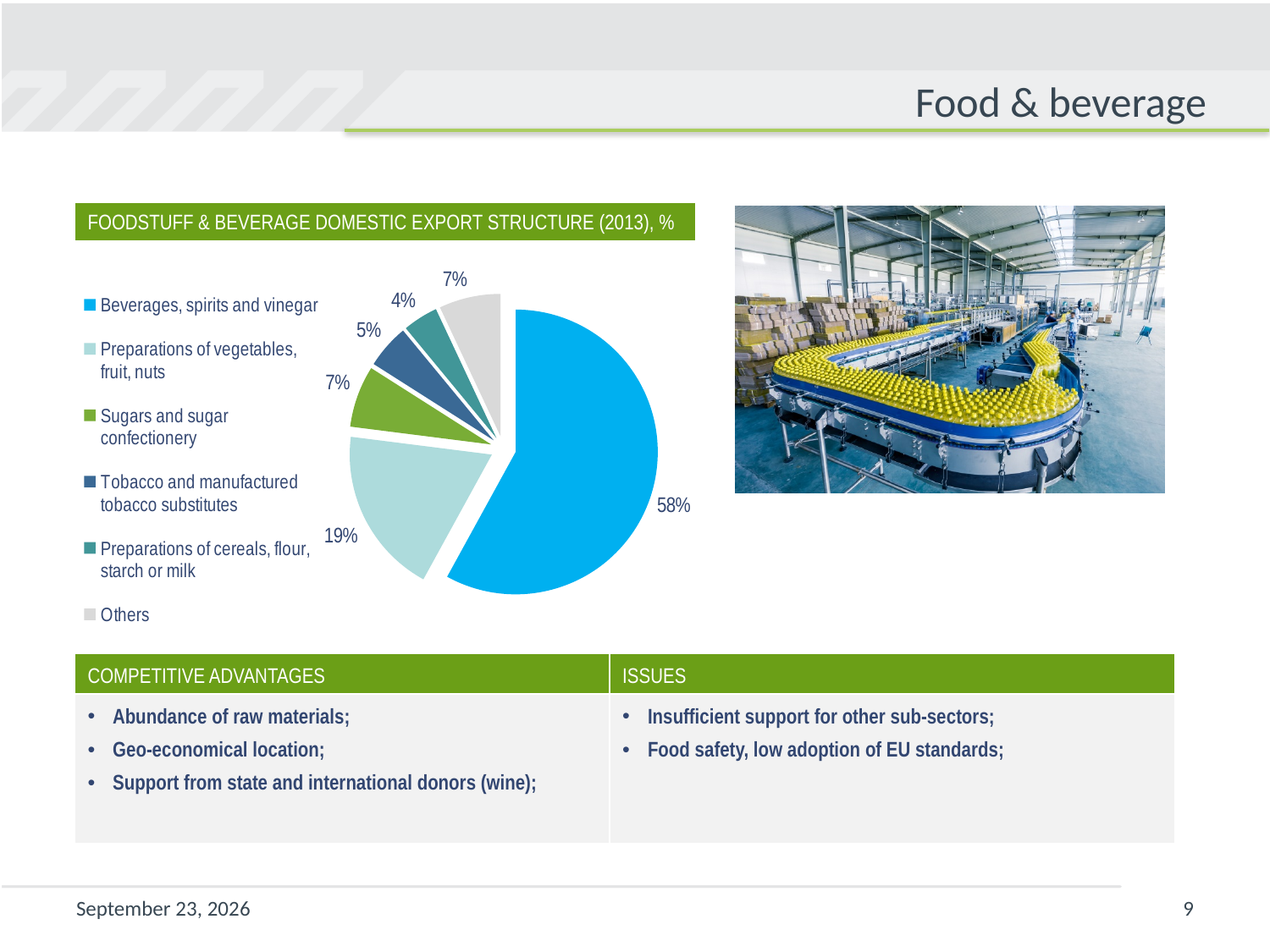
Which is larger: Sugars and sugar confectionery or Tobacco and manufactured tobacco substitutes? Sugars and sugar confectionery What type of chart is shown on the slide? Pie chart What is the difference in percentage points between Beverages, spirits and vinegar and Preparations of vegetables, fruit, nuts? 39 Which category has the largest share of the pie? Beverages, spirits and vinegar What share does the Others slice represent? 7% What percentage is shown for Preparations of vegetables, fruit, nuts? 19% What is the value for Tobacco and manufactured tobacco substitutes? 5% What percentage is shown for Preparations of cereals, flour, starch or milk? 4% What is the title of the chart? FOODSTUFF & BEVERAGE DOMESTIC EXPORT STRUCTURE (2013), % How many categories does the pie chart show? 6 Which category has the smallest share of the pie? Preparations of cereals, flour, starch or milk What share of the pie does Beverages, spirits and vinegar hold? 58%